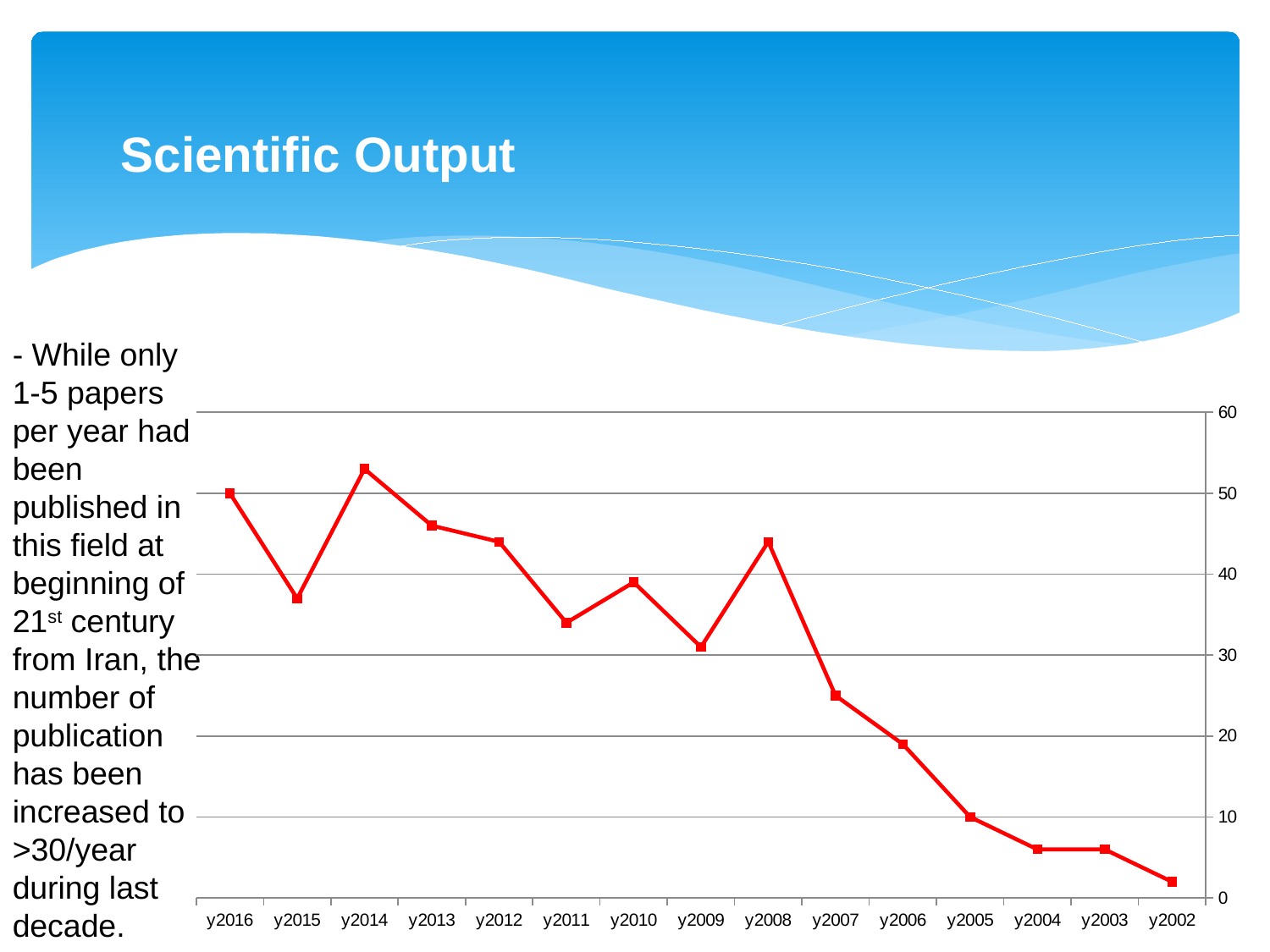
Which year has the highest value on the chart? y2014 Moving from y2016 on the left to y2002 on the right, do the values generally rise or fall? fall Is the value for y2011 greater or less than 40? less What kind of chart is shown on the slide? line chart Which has the larger value, y2010 or y2009? y2010 Which year has the lowest value on the chart? y2002 Is the value for y2015 greater or less than 40? less Is the value for y2007 greater or less than 20? greater How many years are plotted on the x axis of the chart? 15 Which has the larger value, y2014 or y2015? y2014